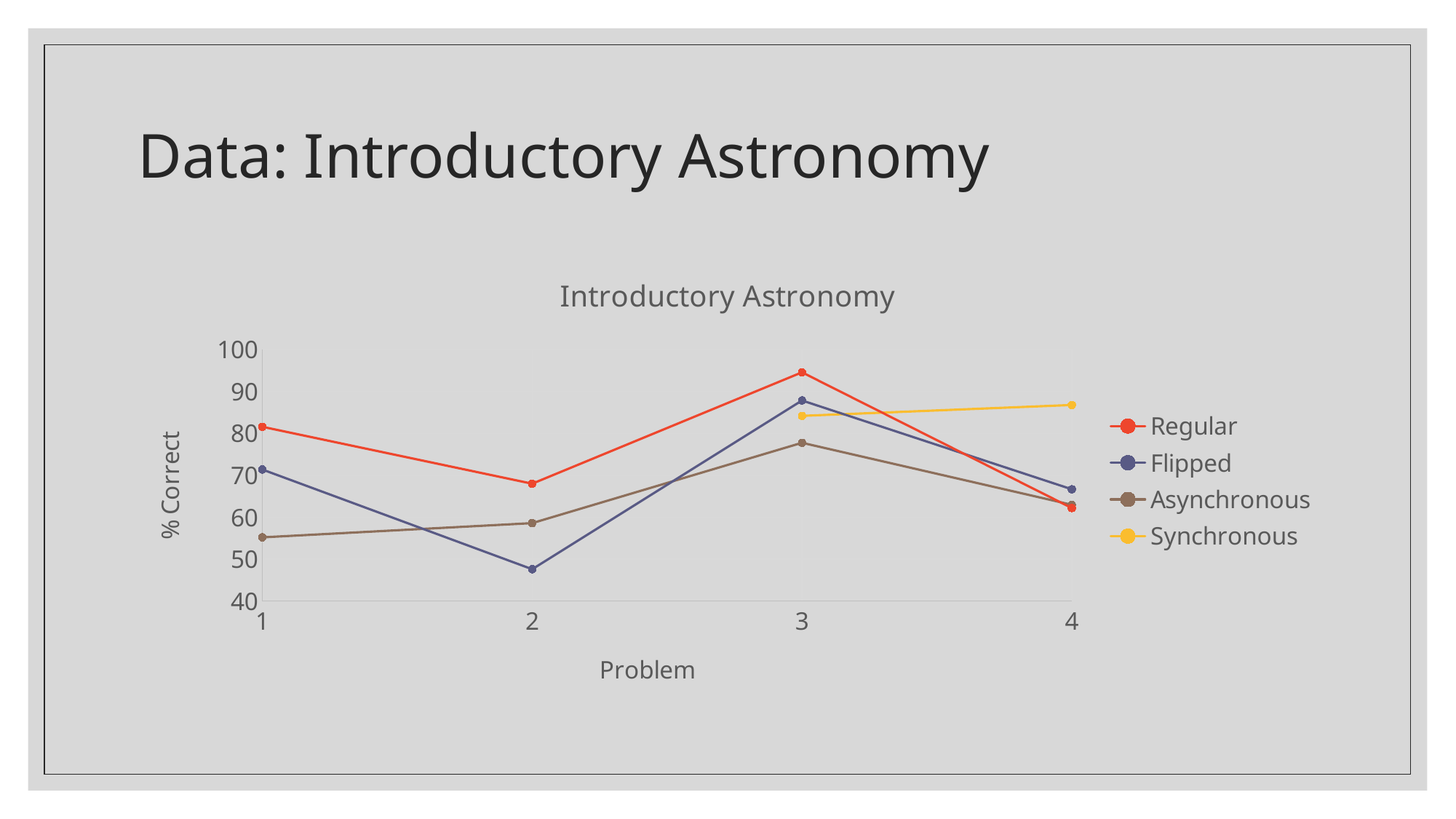
For which problem is the Regular series highest? 3 For which problem is the Flipped series lowest? 2 Is the value for Flipped at problem 2 greater or less than 50? less What kind of chart is shown on the slide? line chart Does the Asynchronous series rise or fall from problem 1 to problem 3? rise How many series does the legend list? 4 Is the value for Asynchronous at problem 1 greater or less than 60? less What is the label on the y axis? % Correct Is the value for Regular at problem 3 greater or less than 90? greater How many problems are shown on the x axis? 4 At problem 4, which is larger: Synchronous or Regular? Synchronous At problem 1, which is larger: Regular or Asynchronous? Regular